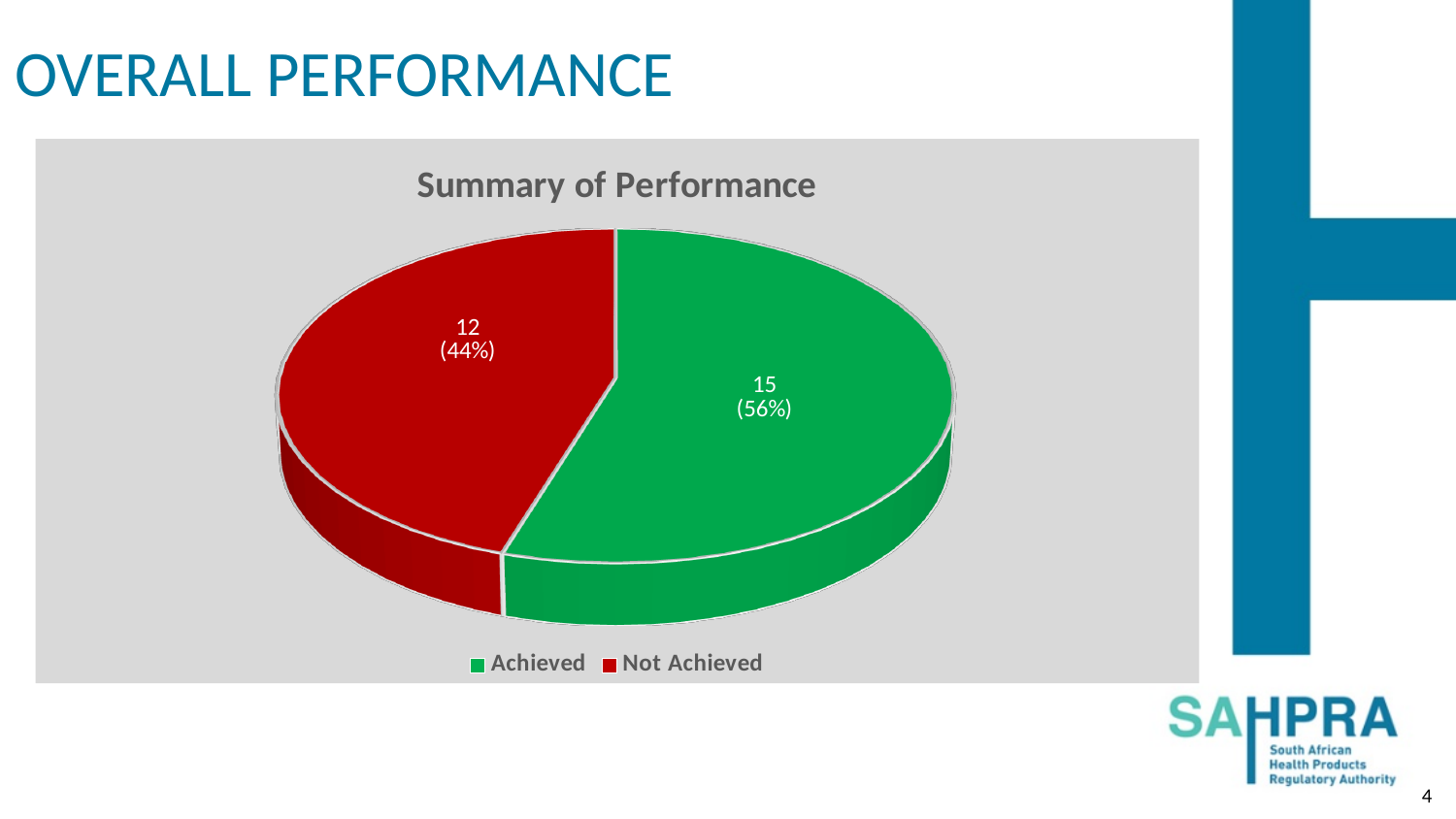
What is the count for Not Achieved? 12 Which category has the smallest slice? Not Achieved How many entries does the legend list? 2 What is the difference between the Achieved and Not Achieved counts? 3 Which colour represents Not Achieved in the chart? Red What kind of chart is shown on the slide? Pie chart What share of the pie is Not Achieved? 44% What is the count for Achieved? 15 How many slices does the pie chart have? 2 Which category has the largest slice? Achieved What share of the pie is Achieved? 56% What is the title of the chart? Summary of Performance